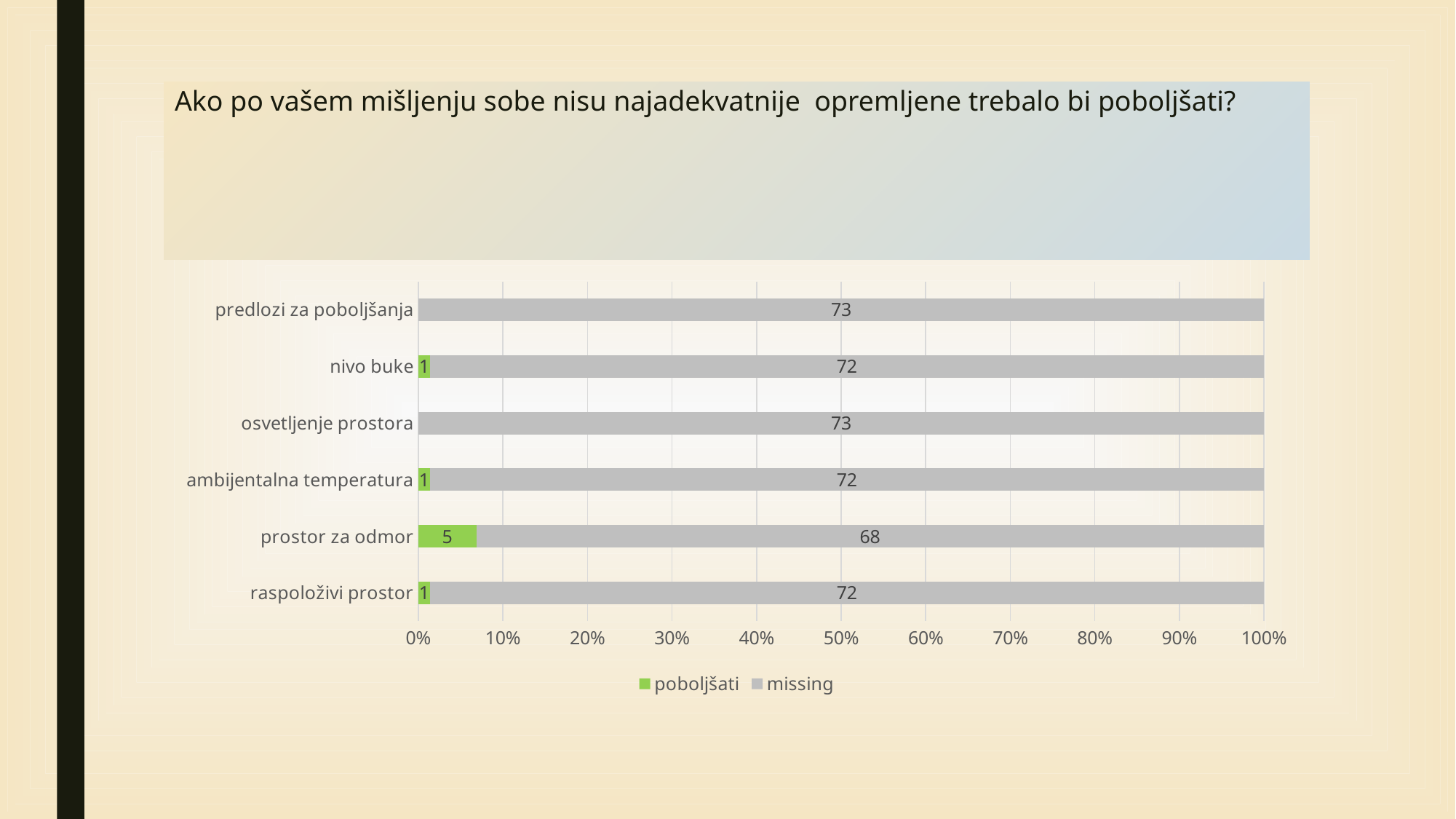
Which is larger: the 'poboljšati' value for prostor za odmor or for raspoloživi prostor? prostor za odmor What is the 'poboljšati' value for prostor za odmor? 5 Which category has the highest 'poboljšati' value? prostor za odmor What kind of chart is shown on the slide? stacked bar chart What is the 'missing' value for nivo buke? 72 What is the 'missing' value for prostor za odmor? 68 What is the difference between the 'missing' values for predlozi za poboljšanja and prostor za odmor? 5 Which category has the lowest 'missing' value? prostor za odmor How many series does the legend list? 2 What is the 'poboljšati' value for ambijentalna temperatura? 1 What is the total of the stacked bar for prostor za odmor? 73 How many categories are shown on the chart? 6